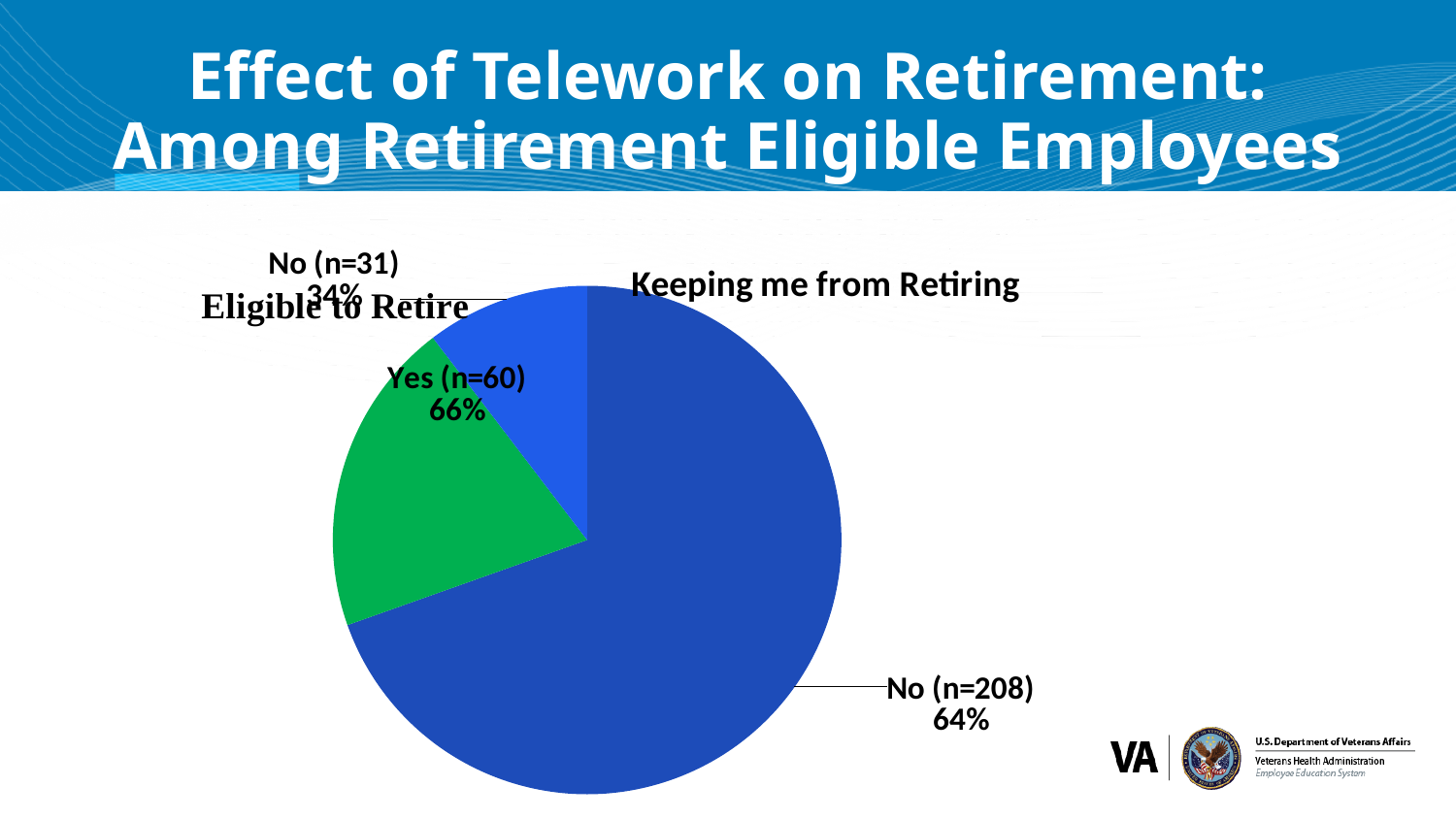
What is the n value printed for the Yes slice? 60 What percentage is printed next to the Yes (n=60) slice? 66% Which slice is larger, No (n=208) or Yes (n=60)? No (n=208) Which slice of the pie chart is the smallest? No (n=31) What is the difference between the n values printed for No (n=208) and Yes (n=60)? 148 What percentage is printed next to the No (n=208) slice? 64% What colour is the largest slice of the pie chart? dark blue What percentage is printed next to the No (n=31) slice? 34% What kind of chart is shown on the slide? pie chart How many slices does the pie chart have? 3 What is the title printed above the pie chart? Keeping me from Retiring Which slice of the pie chart is the largest? No (n=208)